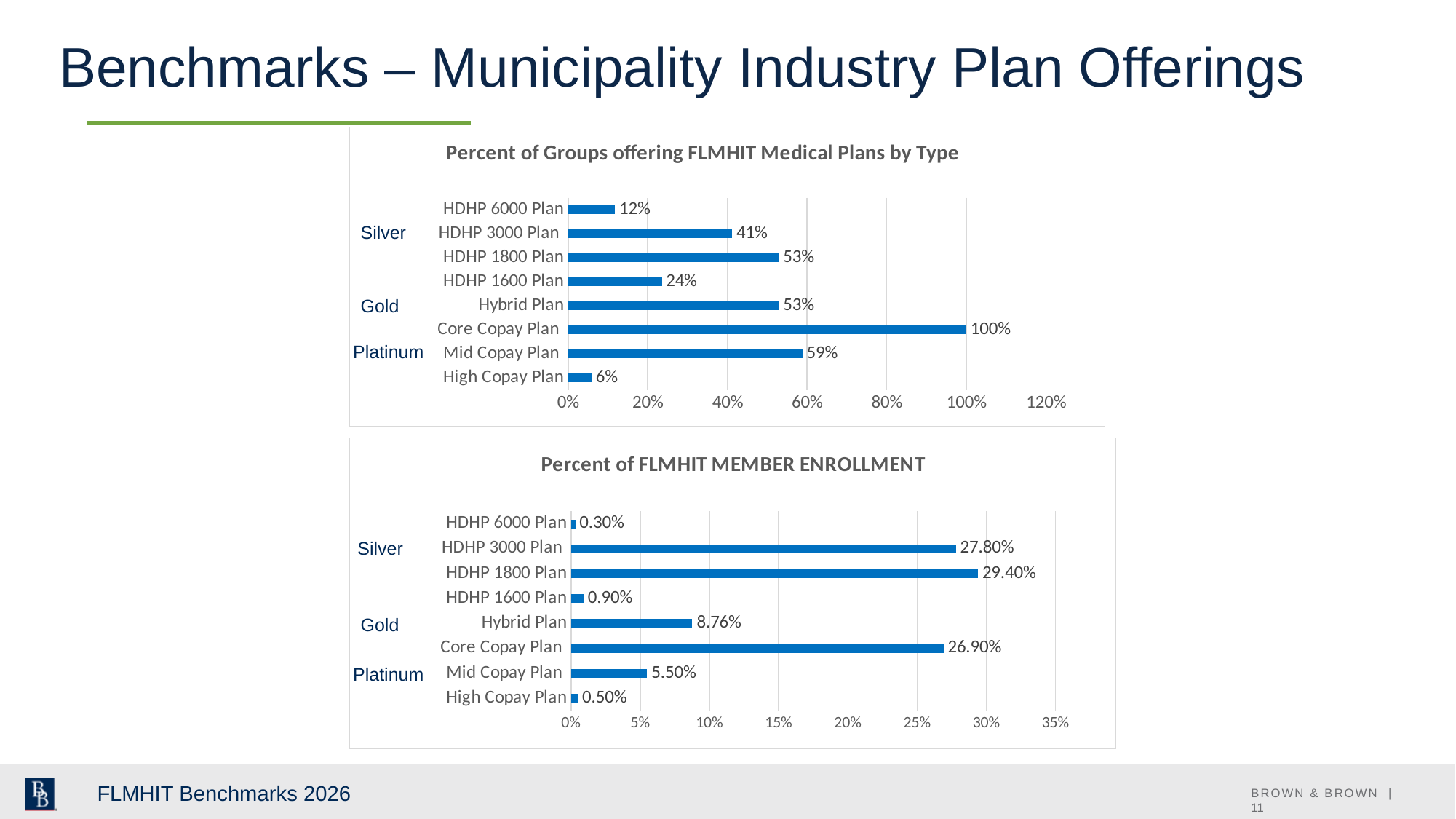
In the 'Percent of Groups offering FLMHIT Medical Plans by Type' chart, what is the value for the Core Copay Plan? 100% In the 'Percent of FLMHIT MEMBER ENROLLMENT' chart, which plan has the lowest value? HDHP 6000 Plan In the 'Percent of Groups offering FLMHIT Medical Plans by Type' chart, what is the value for the HDHP 3000 Plan? 41% In the 'Percent of FLMHIT MEMBER ENROLLMENT' chart, what is the difference between the Mid Copay Plan and the High Copay Plan? 5.00% In the 'Percent of Groups offering FLMHIT Medical Plans by Type' chart, what is the difference between the Mid Copay Plan and the HDHP 1600 Plan? 35% In the 'Percent of FLMHIT MEMBER ENROLLMENT' chart, what is the value for the HDHP 1800 Plan? 29.40% In the 'Percent of FLMHIT MEMBER ENROLLMENT' chart, which plan has the highest value? HDHP 1800 Plan In the 'Percent of Groups offering FLMHIT Medical Plans by Type' chart, how many plans are plotted? 8 In the 'Percent of Groups offering FLMHIT Medical Plans by Type' chart, which plan has the lowest value? High Copay Plan What kind of chart is the 'Percent of FLMHIT MEMBER ENROLLMENT' chart? Bar chart In the 'Percent of FLMHIT MEMBER ENROLLMENT' chart, what is the value for the Hybrid Plan? 8.76% In the 'Percent of FLMHIT MEMBER ENROLLMENT' chart, which is larger: the Core Copay Plan or the HDHP 3000 Plan? HDHP 3000 Plan